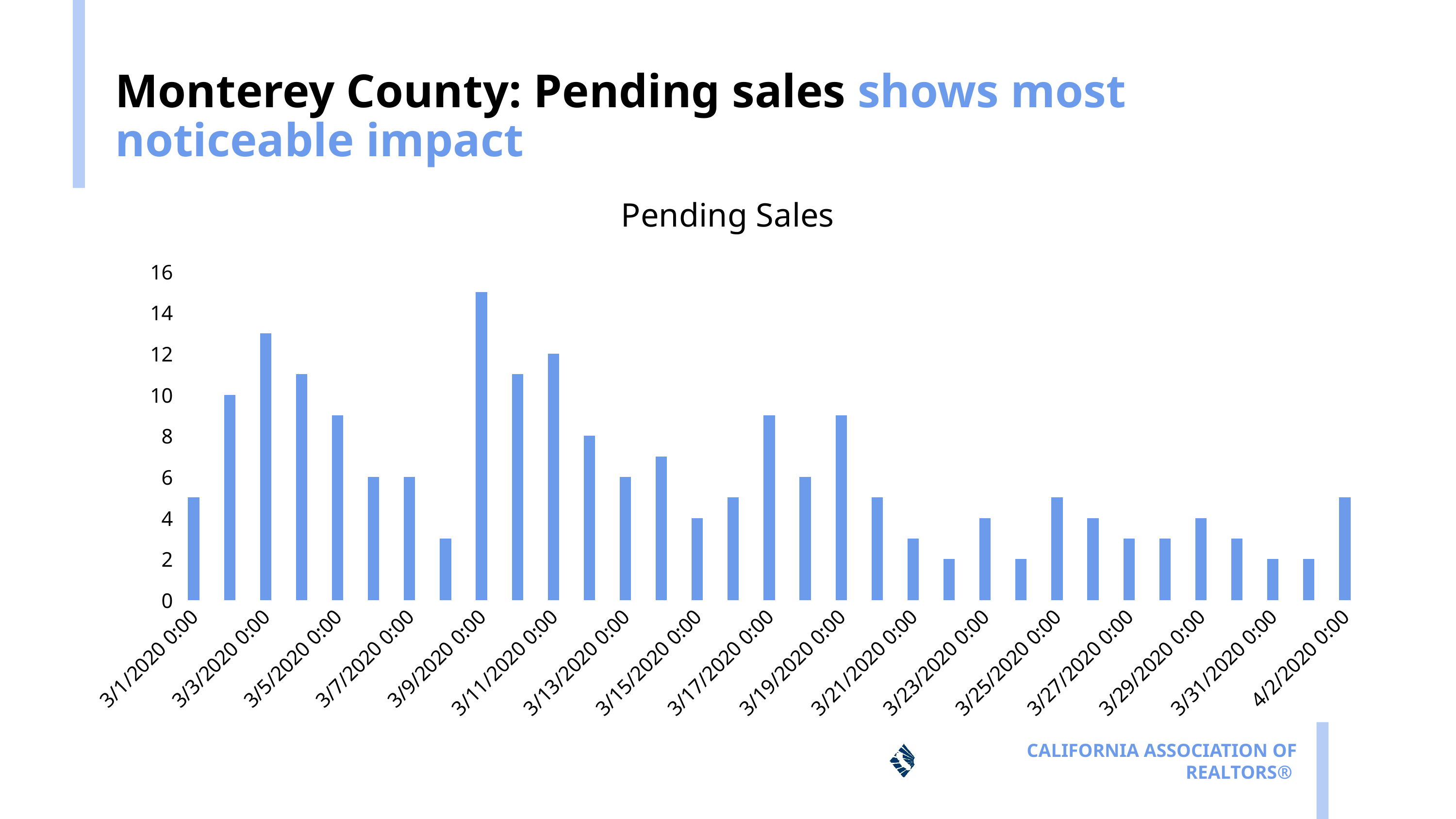
What is the value for 3/23/2020 0:00? 4 What is the difference between the values for 3/11/2020 0:00 and 3/7/2020 0:00? 6 What type of chart is shown on the slide? bar chart Is the value for 3/21/2020 0:00 greater or less than 4? less Which date has the highest pending sales value? 3/9/2020 0:00 Is the value for 3/3/2020 0:00 greater or less than 10? greater Do the pending sales values generally rise or fall from 3/1/2020 to 4/2/2020? fall Which is larger, the value for 3/3/2020 0:00 or the value for 3/19/2020 0:00? 3/3/2020 0:00 What is the value for 3/11/2020 0:00? 12 What is the value for 3/7/2020 0:00? 6 What is the value for 3/31/2020 0:00? 2 What is the title of the chart? Pending Sales